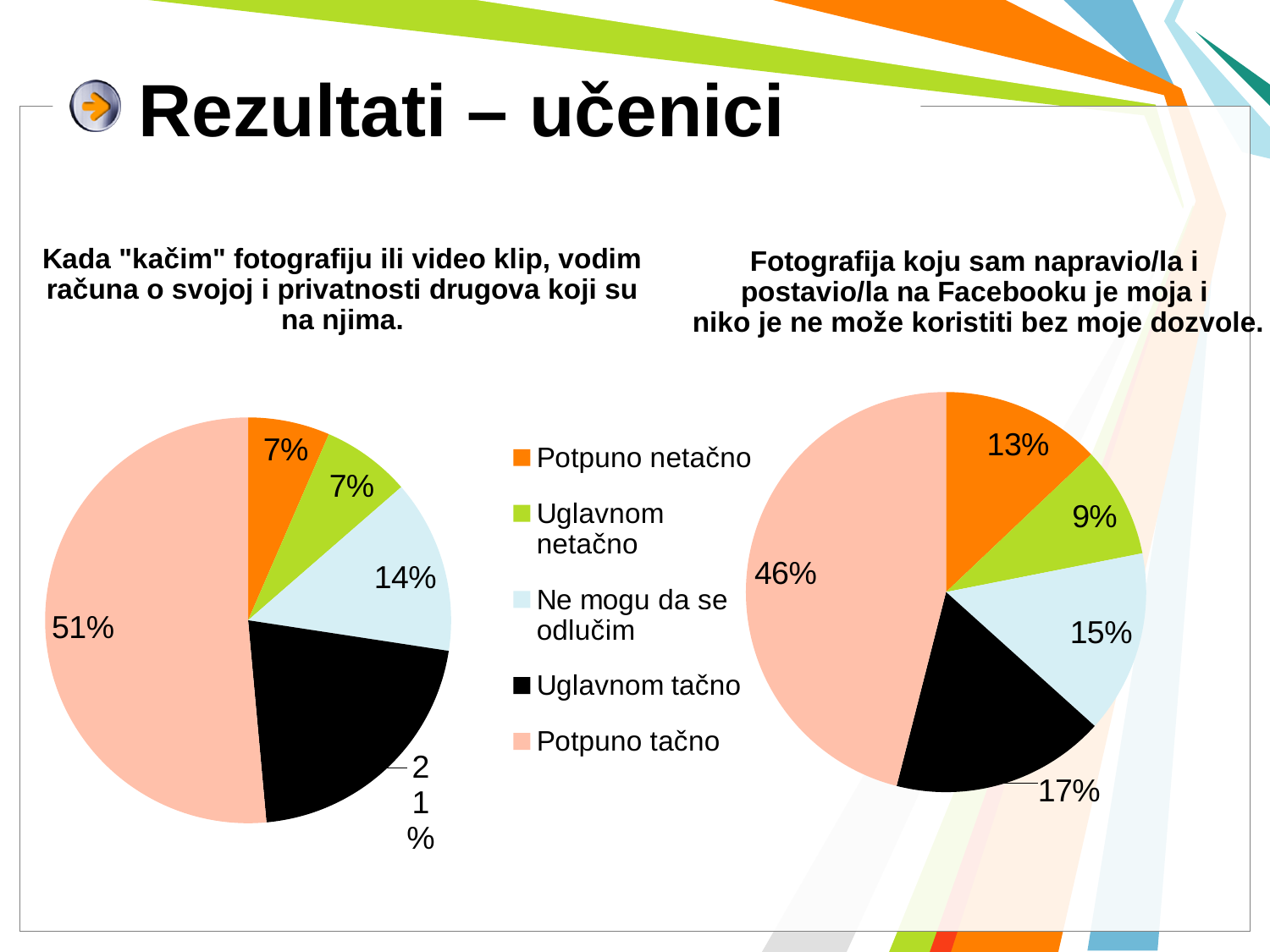
How many categories does the legend list? 5 In the left pie chart ("Kada "kačim" fotografiju ili video klip..."), what share is labelled for Potpuno tačno? 51% Which chart has the larger share for Potpuno tačno, the left one or the right one? The left one What kind of charts are shown on the slide? Pie charts In the left pie chart ("Kada "kačim" fotografiju ili video klip..."), what share is labelled for Uglavnom tačno? 21% Which colour represents Uglavnom tačno in the legend? Black In the left pie chart ("Kada "kačim" fotografiju ili video klip..."), what share is labelled for Ne mogu da se odlučim? 14% In the right pie chart ("Fotografija koju sam napravio/la..."), what share is labelled for Potpuno netačno? 13% In the right pie chart ("Fotografija koju sam napravio/la..."), which category has the largest slice? Potpuno tačno In the left pie chart ("Kada "kačim" fotografiju ili video klip..."), what is the difference between the Potpuno tačno share and the Uglavnom tačno share? 30% In the right pie chart ("Fotografija koju sam napravio/la..."), what share is labelled for Uglavnom netačno? 9% In the right pie chart ("Fotografija koju sam napravio/la..."), which category has the smallest slice? Uglavnom netačno